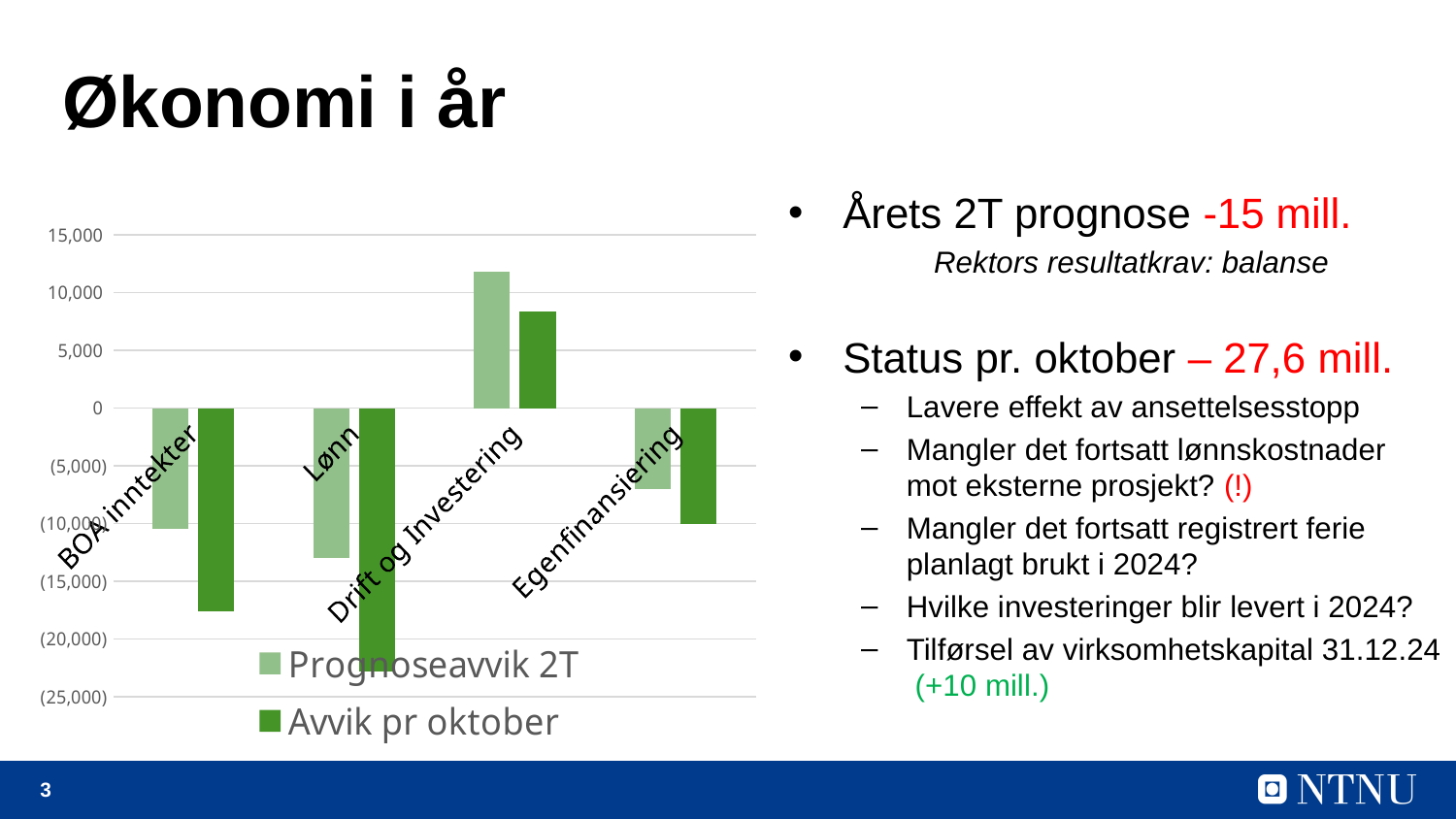
Is the Avvik pr oktober value for BOA inntekter greater or less than -15,000? less How many categories are shown on the x axis of the chart? 4 What are the two series named in the chart legend? Prognoseavvik 2T and Avvik pr oktober What kind of chart is shown on the slide? Bar chart Which series is drawn in the darker green colour? Avvik pr oktober How many series does the chart legend list? 2 For Drift og Investering, which series has the larger value: Prognoseavvik 2T or Avvik pr oktober? Prognoseavvik 2T Is the Avvik pr oktober value for Lønn greater or less than -20,000? less Which category has the lowest value for the Avvik pr oktober series? Lønn Which category has the highest value for the Prognoseavvik 2T series? Drift og Investering Is the Prognoseavvik 2T value for Drift og Investering greater or less than 10,000? greater Which category has the highest value for the Avvik pr oktober series? Drift og Investering